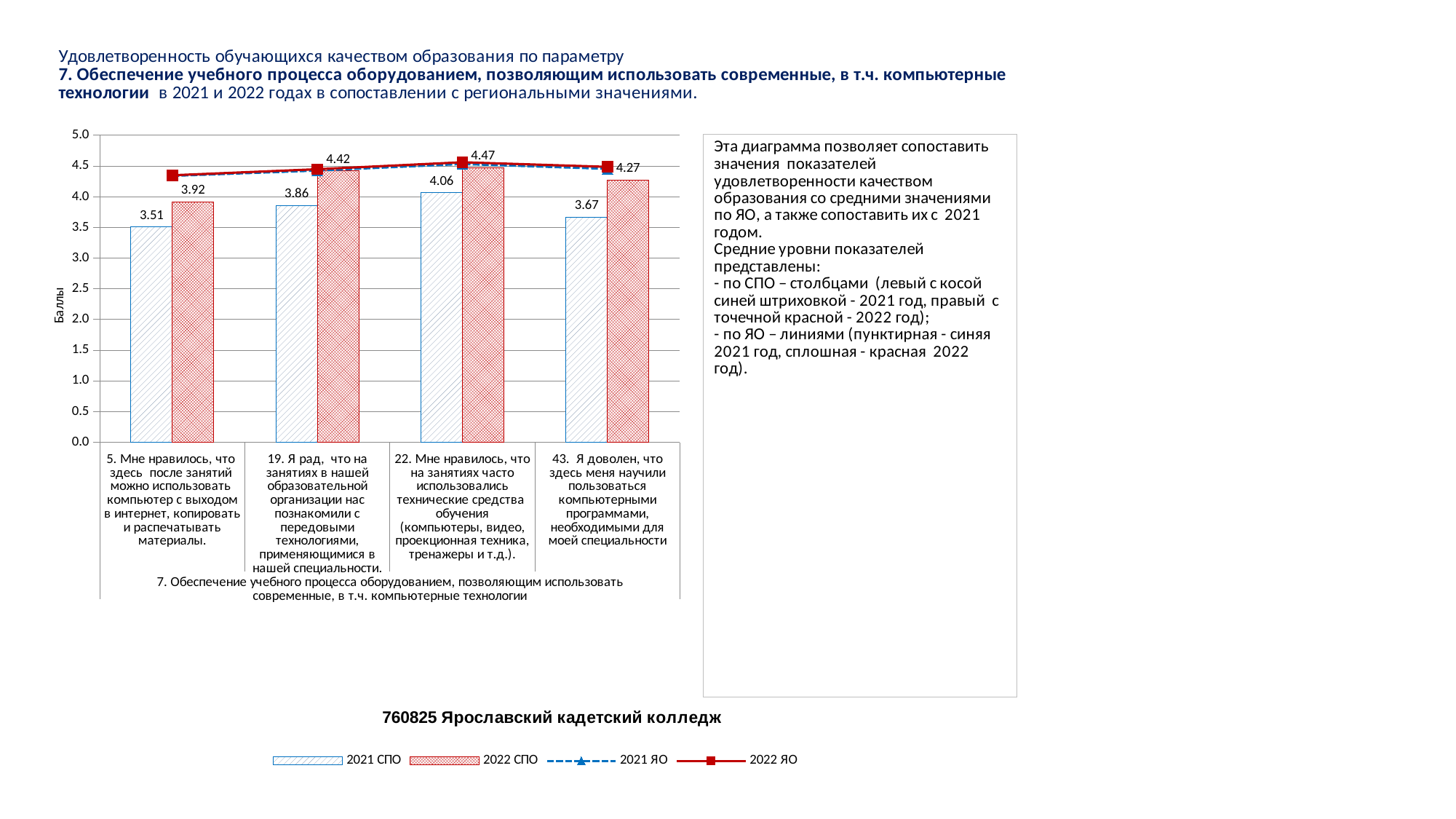
What is the 2022 СПО value for question 22 ("Мне нравилось, что на занятиях часто использовались технические средства обучения...")? 4.47 What is the 2022 СПО value for question 43 ("Я доволен, что здесь меня научили пользоваться компьютерными программами...")? 4.27 How many question categories are shown on the x axis? 4 Which question has the highest 2021 СПО value? 22. Мне нравилось, что на занятиях часто использовались технические средства обучения What kind of chart is shown on the slide? Combined bar and line chart Which is larger for question 43: the 2021 СПО value or the 2022 СПО value? 2022 СПО Which question has the lowest 2022 СПО value? 5. Мне нравилось, что здесь после занятий можно использовать компьютер с выходом в интернет Is the 2022 ЯО value for question 5 greater or less than 4.0? greater What is the difference between the 2022 СПО and 2021 СПО values for question 19? 0.56 How many series does the legend list? 4 What is the label of the y axis? Баллы What is the 2021 СПО value for question 5 ("Мне нравилось, что здесь после занятий можно использовать компьютер с выходом в интернет...")? 3.51